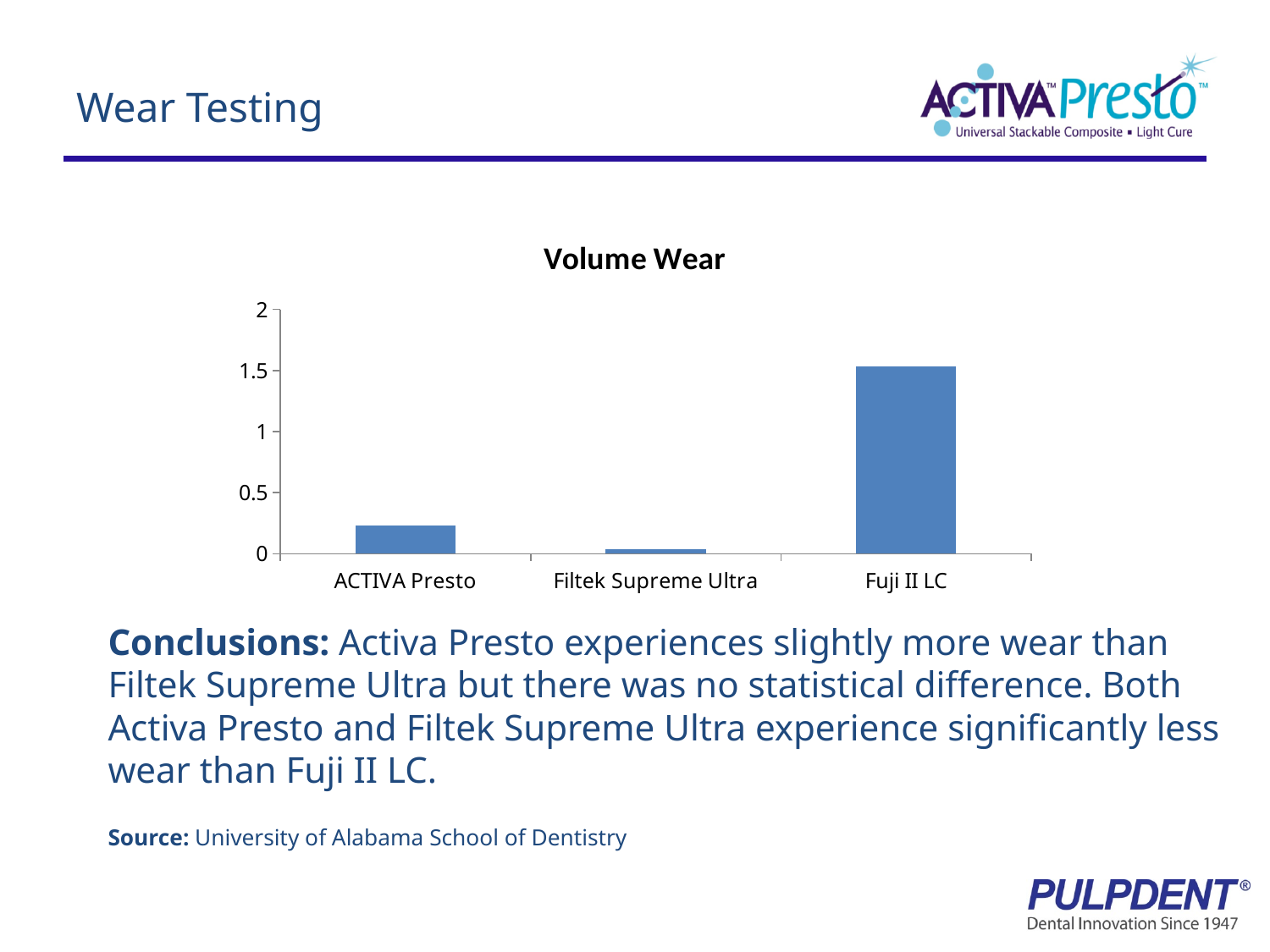
Which has a larger volume wear value, ACTIVA Presto or Fuji II LC? Fuji II LC What is the title of the chart? Volume Wear Is the value for ACTIVA Presto greater or less than 0.5? less Is the value for Filtek Supreme Ultra greater or less than 0.5? less Which category has the highest volume wear? Fuji II LC How many categories are plotted in the Volume Wear chart? 3 What kind of chart is shown on the slide? bar chart Which category has the lowest volume wear? Filtek Supreme Ultra Which has a larger volume wear value, ACTIVA Presto or Filtek Supreme Ultra? ACTIVA Presto Is the value for Fuji II LC greater or less than 1? greater What is the highest value shown on the vertical axis of the chart? 2